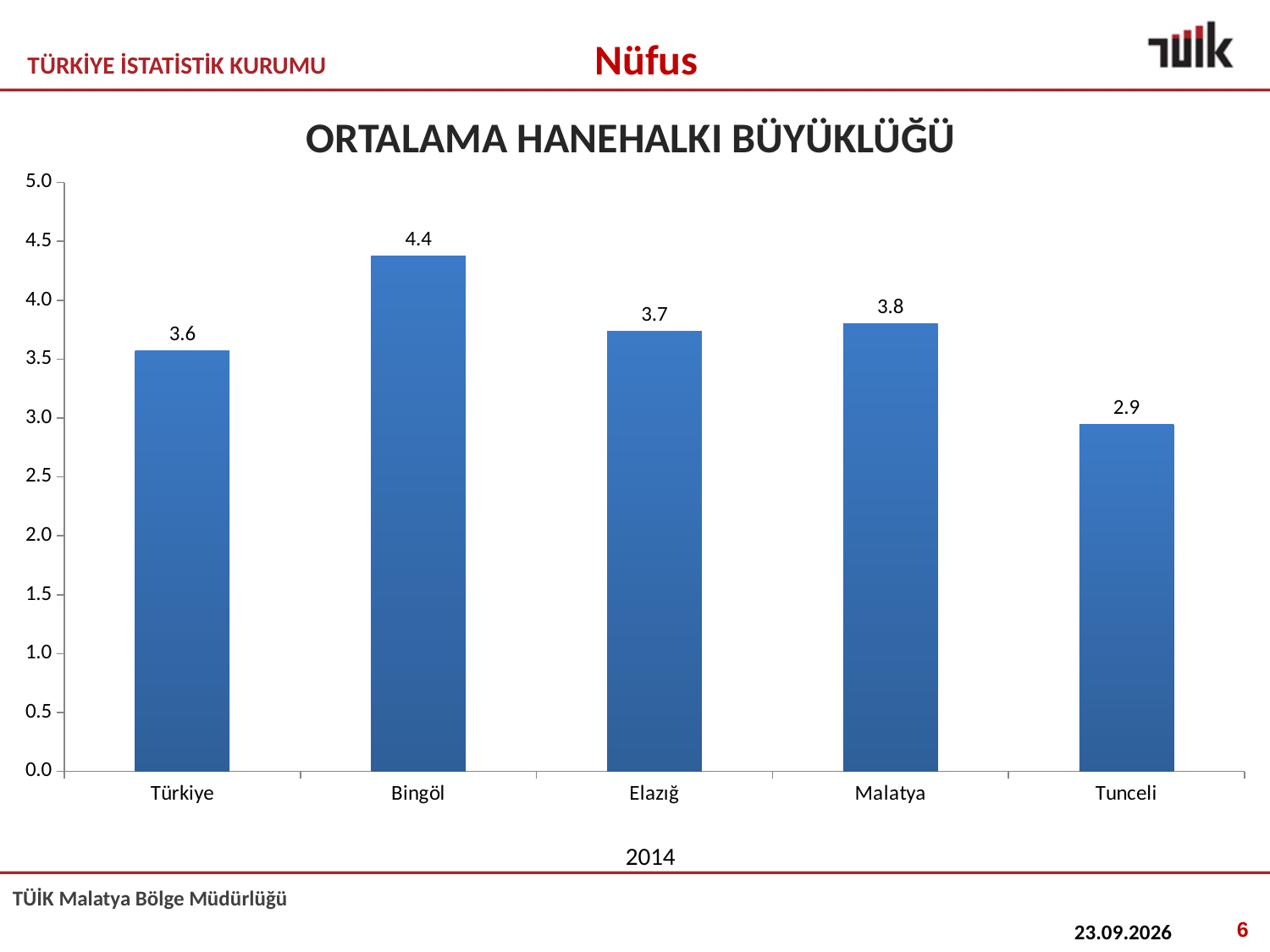
What is the value shown for Tunceli? 2.9 What is the average household size shown for Bingöl? 4.4 How many categories are shown on the x axis? 5 Which category has the lowest average household size? Tunceli What kind of chart is shown on the slide? bar chart Which is larger, the value for Bingöl or the value for Malatya? Bingöl What is the value shown for Türkiye? 3.6 Is the value for Tunceli greater or less than 3.0? less Which category has the highest average household size? Bingöl What is the difference between the values for Malatya and Elazığ? 0.1 What is the title of the chart? ORTALAMA HANEHALKI BÜYÜKLÜĞÜ What is the difference between the values for Bingöl and Tunceli? 1.5